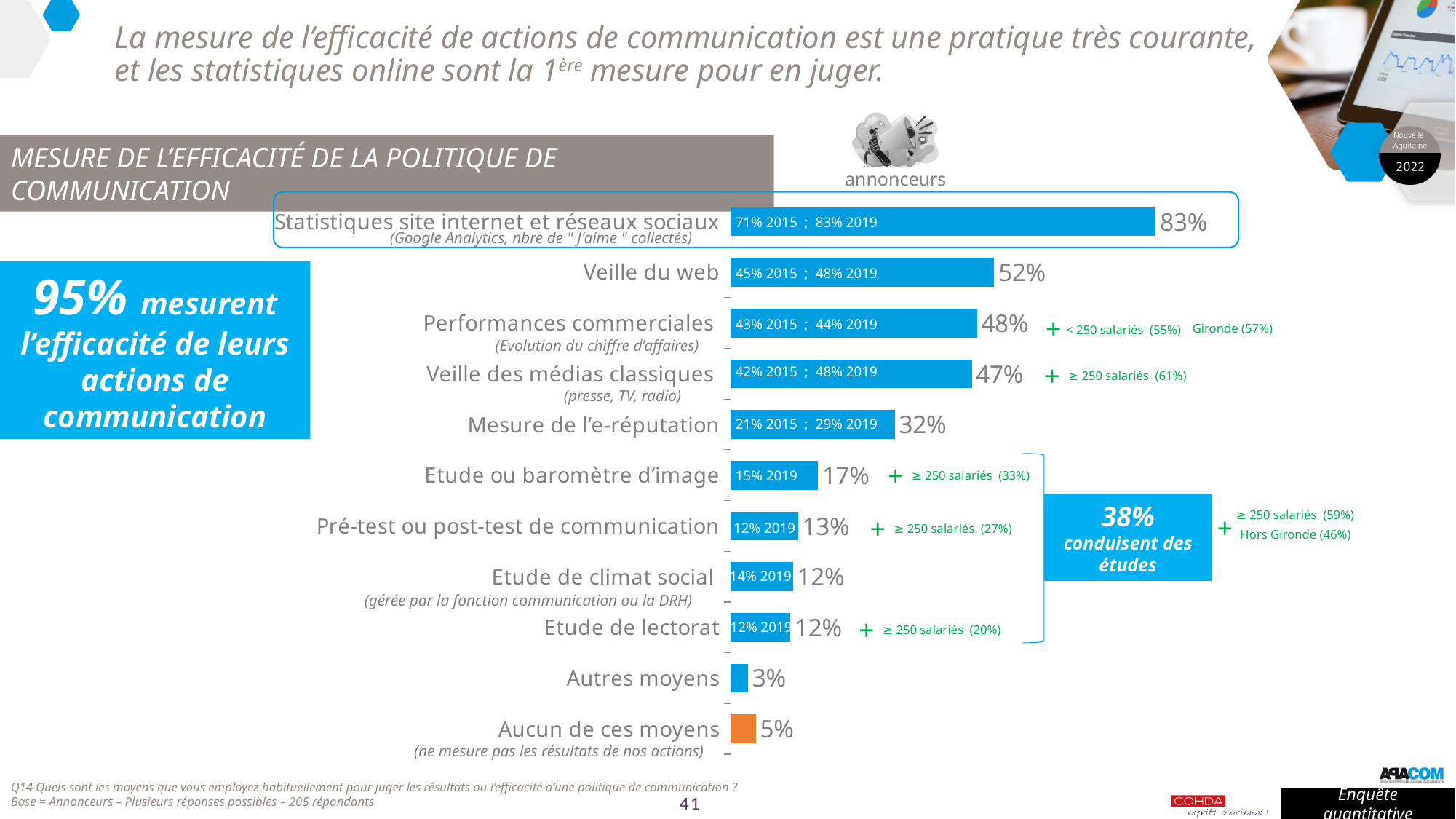
What is the value for "Veille du web"? 52% What is the value for "Mesure de l'e-réputation"? 32% Which category's bar is coloured orange instead of blue? Aucun de ces moyens How many categories are plotted in the chart? 11 What is the value for "Statistiques site internet et réseaux sociaux"? 83% Which category has the highest value? Statistiques site internet et réseaux sociaux What kind of chart is shown on the slide? bar chart What is the difference between the values for "Veille du web" and "Performances commerciales"? 4% What was the 2015 value printed inside the bar for "Veille des médias classiques"? 42% What is the value for "Aucun de ces moyens"? 5% Which category has the lowest value? Autres moyens Which is larger, the value for "Etude ou baromètre d'image" or the value for "Pré-test ou post-test de communication"? Etude ou baromètre d'image